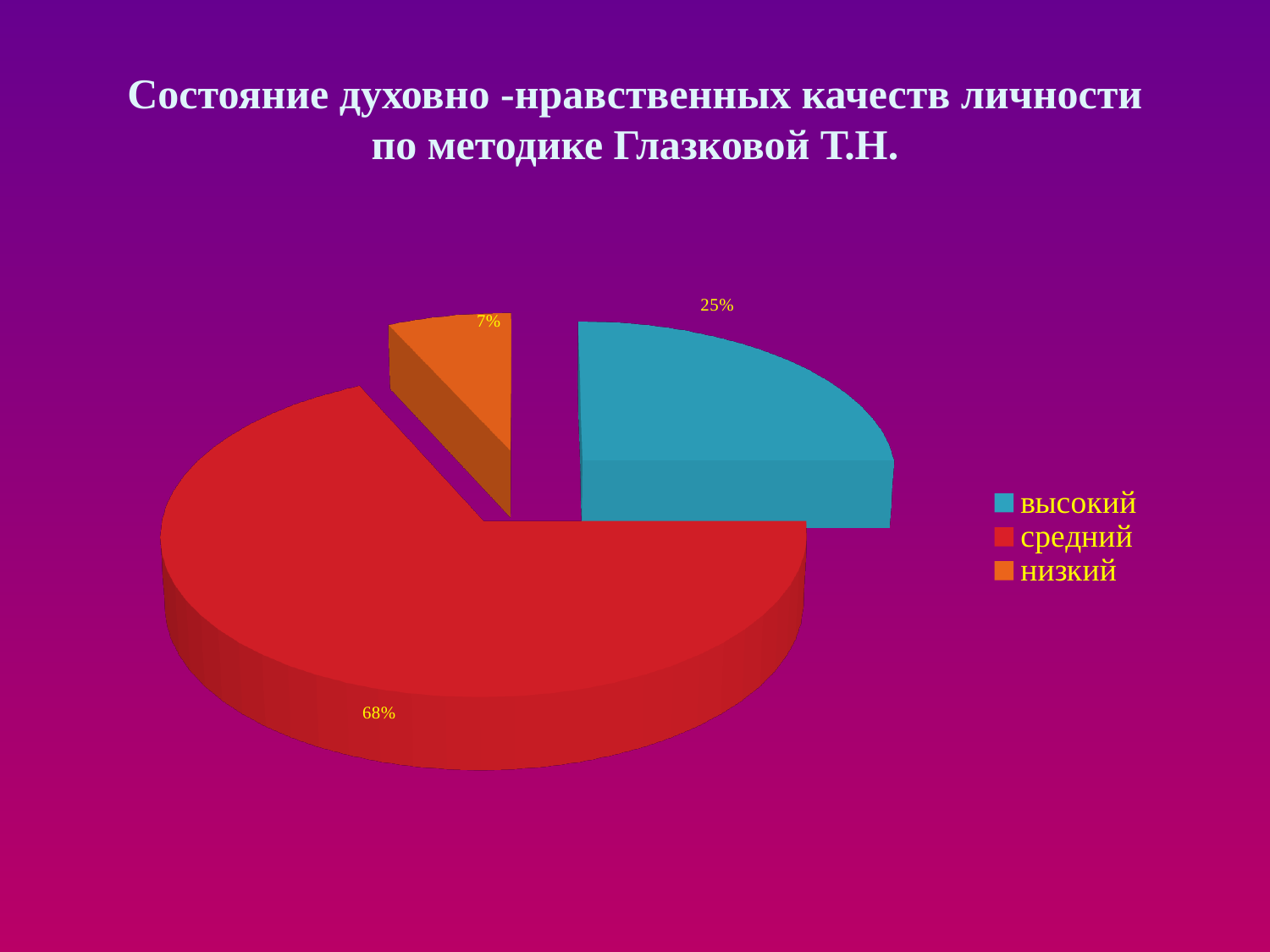
Which category has the largest share of the pie? средний How many entries does the legend list? 3 What percentage is shown for the 'низкий' slice? 7% Which slice is larger, 'высокий' or 'низкий'? высокий What is the difference in percentage points between the 'средний' and 'высокий' slices? 43 What colour is the 'средний' slice? red Which category has the smallest share of the pie? низкий What percentage is shown for the 'средний' slice? 68% What percentage of the pie chart is labelled for the 'высокий' slice? 25% What type of chart is shown on the slide? pie chart What is the title of the slide? Состояние духовно -нравственных качеств личности по методике Глазковой Т.Н. How many slices does the pie chart have? 3